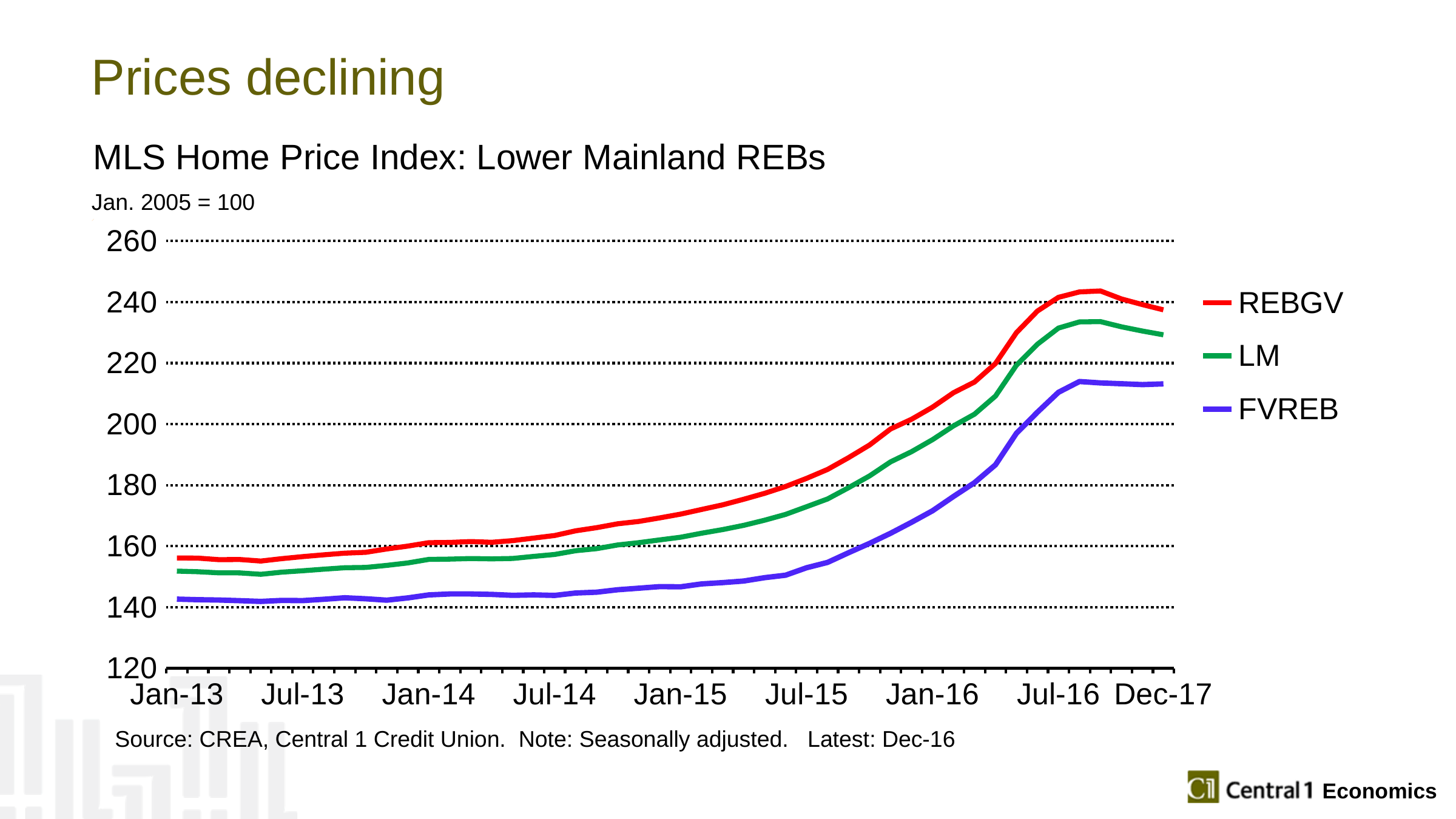
At Jan-13, which is larger: the value for REBGV or the value for FVREB? REBGV Do the index values generally rise or fall from Jan-13 to Jul-16? rise Is the value for FVREB at Jan-13 greater or less than 160? less Is the peak value of REBGV greater or less than 240? greater What is the base period of the index, as stated on the slide? Jan. 2005 = 100 How many series does the legend list? 3 Which series are listed in the legend? REBGV, LM, FVREB Is the value for REBGV at Jan-13 greater or less than 140? greater What kind of chart is shown on the slide? line chart Which series has the highest values across the whole chart? REBGV Which series has the lowest values across the whole chart? FVREB